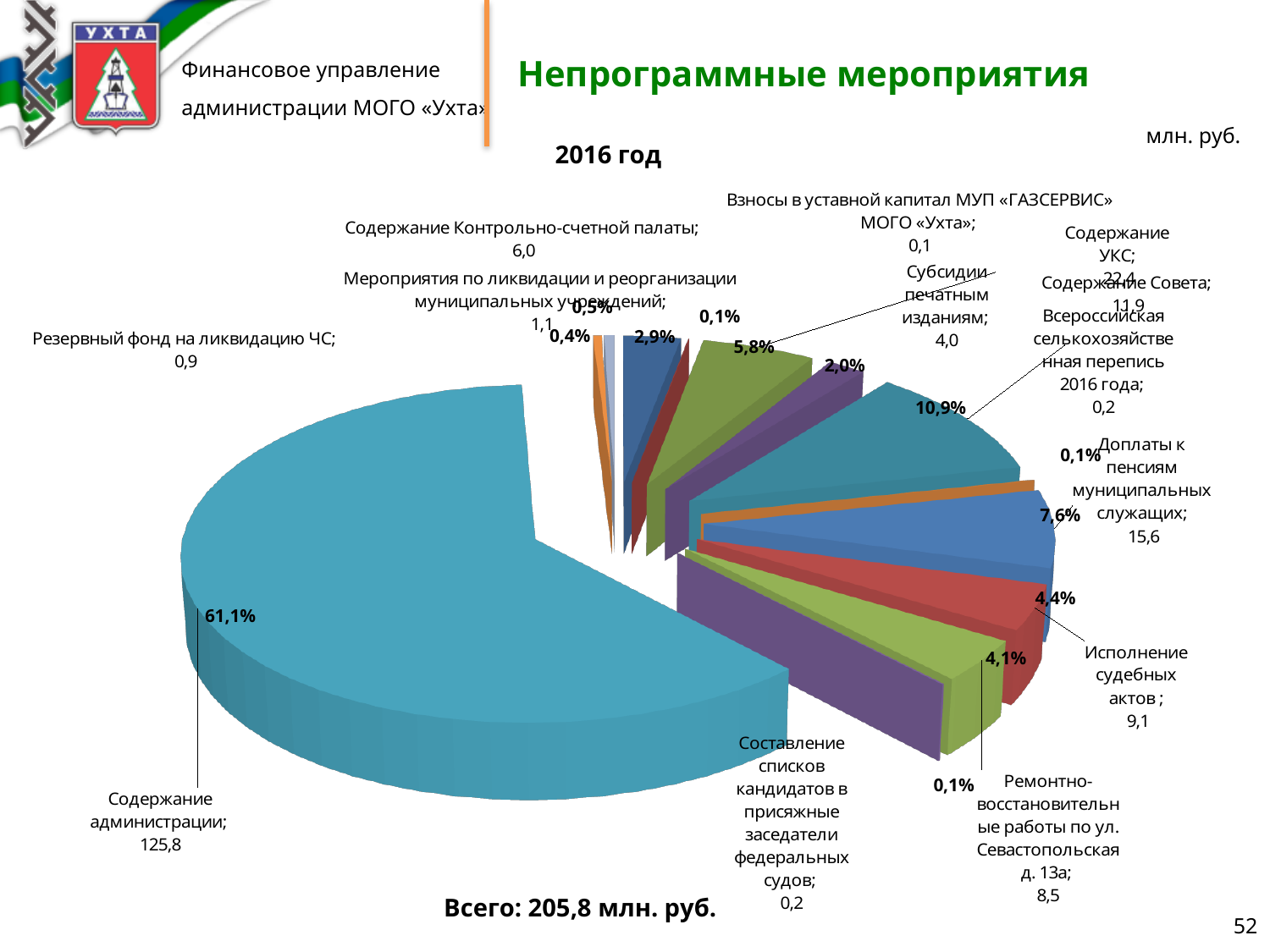
Which category has the smallest value? Взносы в уставной капитал МУП «ГАЗСЕРВИС» МОГО «Ухта» What is the value for «Доплаты к пенсиям муниципальных служащих»? 15,6 Which is larger: the value for «Исполнение судебных актов» or for «Ремонтно-восстановительные работы по ул. Севастопольская д. 13а»? Исполнение судебных актов What share of the pie does «Содержание УКС» take? 10,9% What is the value for «Субсидии печатным изданиям»? 4,0 What is the value for «Содержание Контрольно-счетной палаты»? 6,0 What is the value for «Исполнение судебных актов»? 9,1 What kind of chart is shown on the slide? pie chart What is the difference between the values for «Содержание УКС» and «Содержание Совета»? 10,5 What share of the pie does «Содержание администрации» take? 61,1% What is the value for «Содержание администрации»? 125,8 Which category has the largest slice of the pie? Содержание администрации